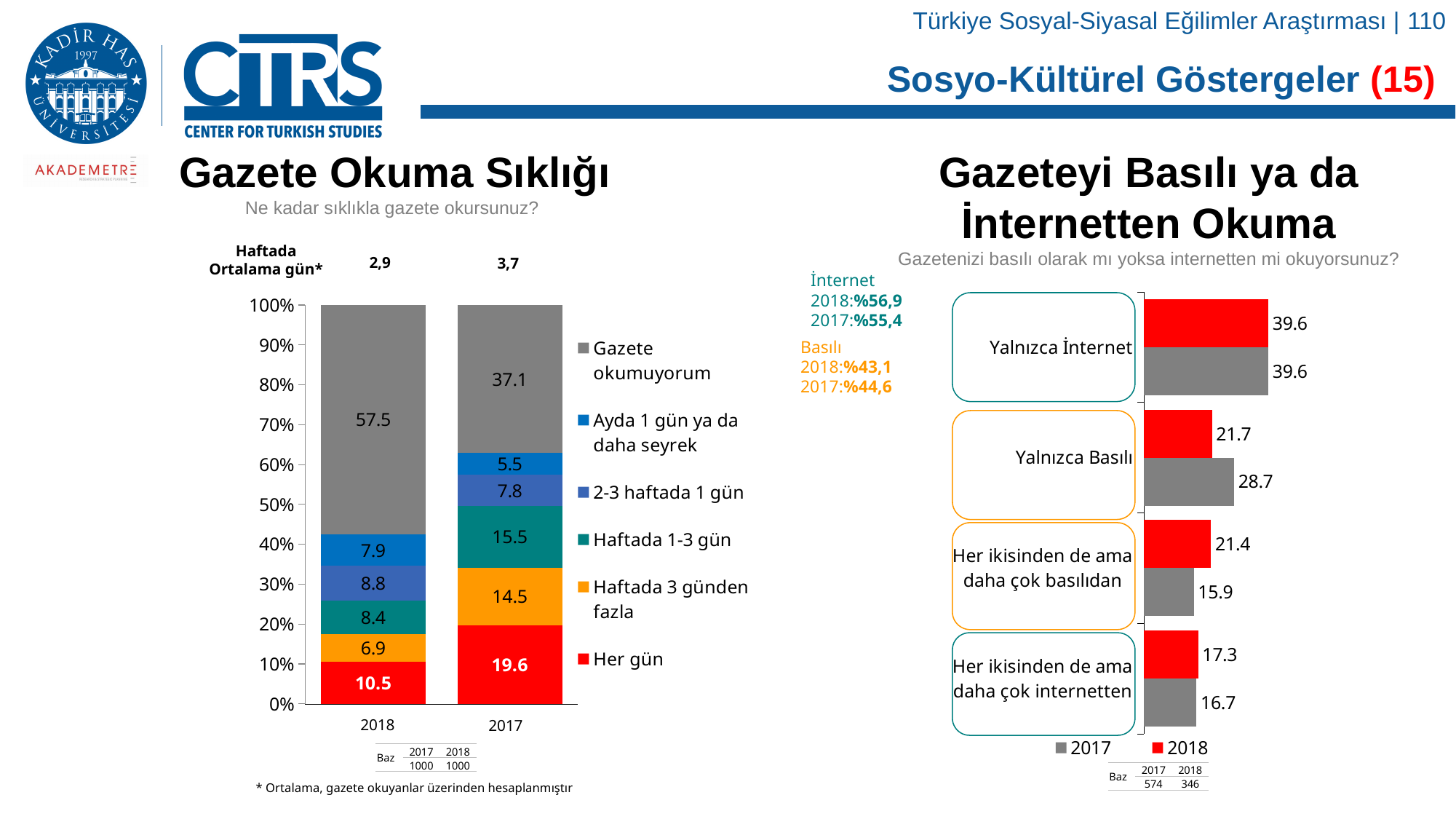
In the 'Gazeteyi Basılı ya da İnternetten Okuma' chart, how many categories are shown? 4 In the 'Gazete Okuma Sıklığı' chart, how many series does the legend list? 6 In the 'Gazeteyi Basılı ya da İnternetten Okuma' chart, which is larger for 'Yalnızca Basılı': the 2017 value or the 2018 value? 2017 In the 'Gazete Okuma Sıklığı' chart, which segment is the largest in the 2018 bar? Gazete okumuyorum In the 'Gazeteyi Basılı ya da İnternetten Okuma' chart, which category has the highest 2018 value? Yalnızca İnternet In the 'Gazeteyi Basılı ya da İnternetten Okuma' chart, what is the 2018 value for 'Her ikisinden de ama daha çok basılıdan'? 21.4 In the 'Gazete Okuma Sıklığı' chart, what is the value of 'Her gün' for 2018? 10.5 In the 'Gazeteyi Basılı ya da İnternetten Okuma' chart, which colour represents 2018? Red In the 'Gazete Okuma Sıklığı' chart, what is the difference between the 'Gazete okumuyorum' values for 2018 and 2017? 20.4 In the 'Gazeteyi Basılı ya da İnternetten Okuma' chart, what is the 2017 value for 'Yalnızca Basılı'? 28.7 What type of chart is 'Gazete Okuma Sıklığı'? Stacked bar chart In the 'Gazete Okuma Sıklığı' chart, what is the value of 'Gazete okumuyorum' for 2017? 37.1